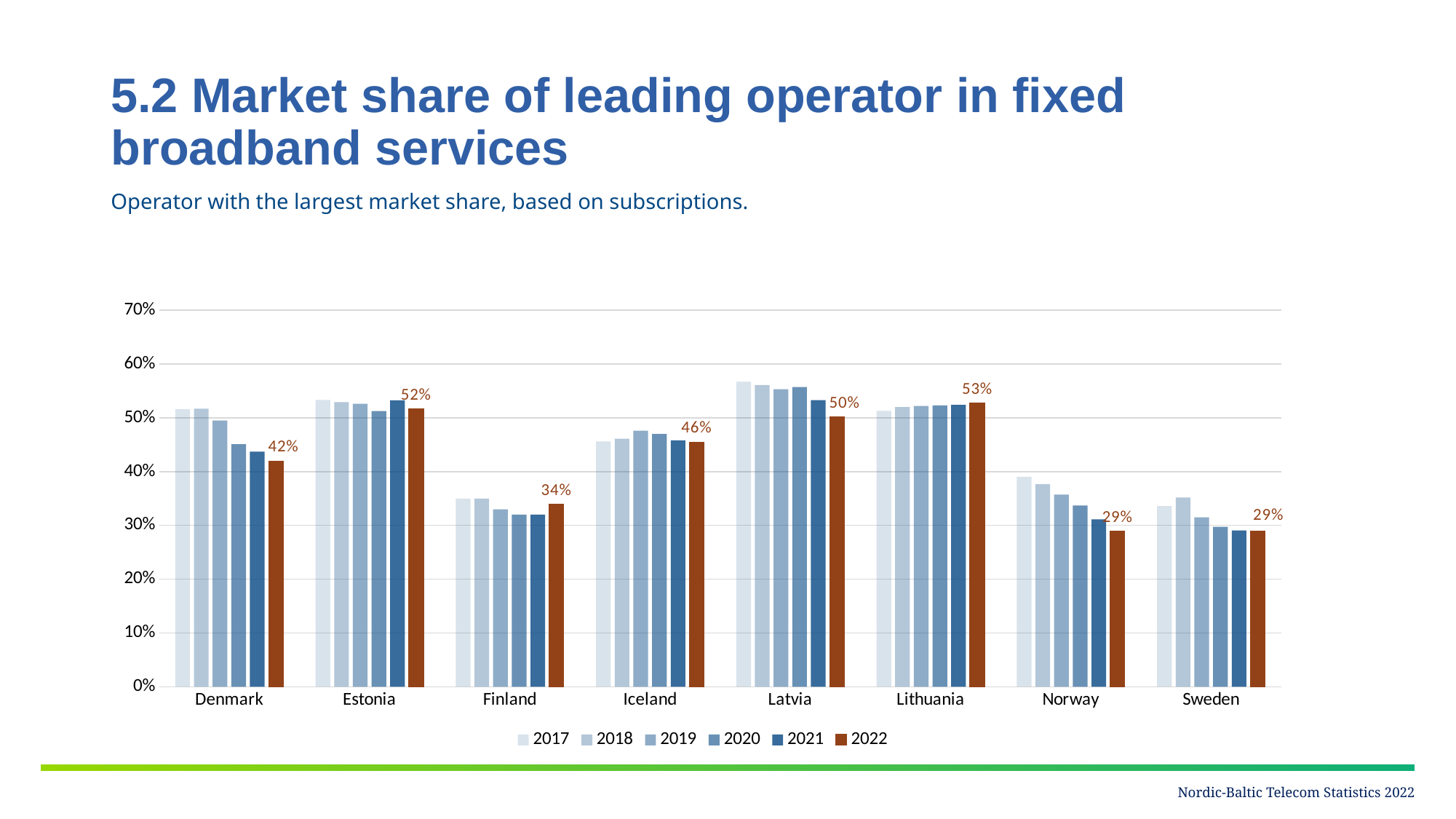
How many series (years) does the legend list? 6 Which country has the highest 2022 market share of the leading operator? Lithuania What is the 2022 value shown for Lithuania? 53% Which is larger, the 2022 value for Iceland or the 2022 value for Denmark? Iceland Is the 2017 value for Latvia greater or less than 50%? greater Is the 2017 value for Finland greater or less than 40%? less Do the values for Norway rise or fall from 2017 to 2022? Fall How many countries are shown on the x axis of the chart? 8 What is the 2022 market share of the leading operator in fixed broadband services in Denmark? 42% What is the difference between the 2022 values for Lithuania and Finland? 19 percentage points What is the 2022 value shown for Finland? 34% What kind of chart is shown on the slide? Bar chart